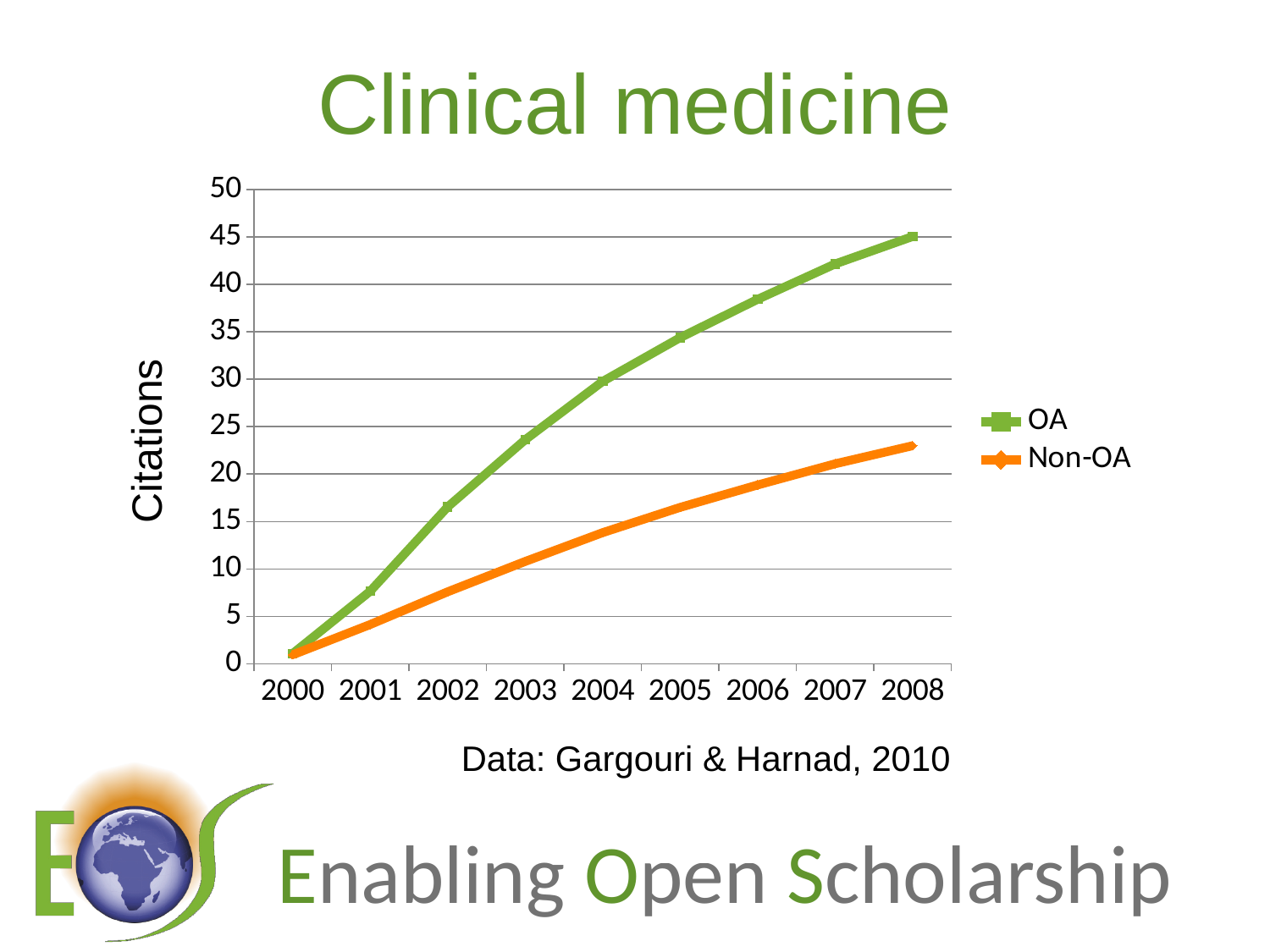
Is the OA value for 2008 greater or less than 40? greater Is the Non-OA value for 2008 greater or less than 25? less Is the OA value for 2003 greater or less than 20? greater How many years are shown along the x axis? 9 Do the OA citations rise or fall from 2000 to 2008? rise What kind of chart is shown on the slide? line chart How many series does the legend list? 2 In 2008, which series has more citations, OA or Non-OA? OA In which year does the OA series reach its highest value? 2008 Do the Non-OA citations rise or fall from 2000 to 2008? rise What is the label on the y axis? Citations